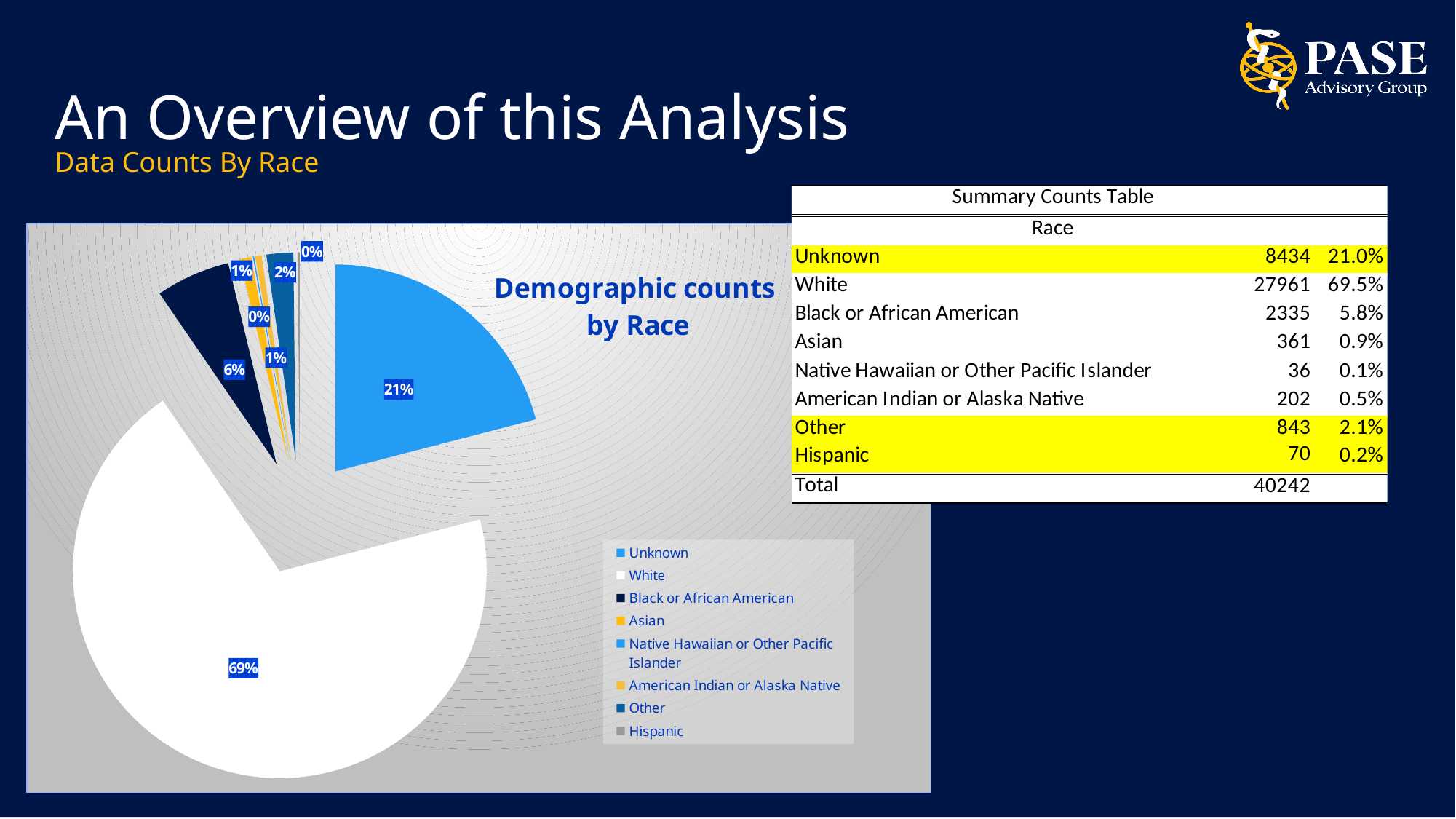
Which slice is larger, Unknown or Black or African American? Unknown What share of the pie does the Other slice represent? 2% What share of the pie does the White slice represent? 69% Which slice is larger, Other or Black or African American? Black or African American How many categories does the pie chart's legend list? 8 What share of the pie does the Black or African American slice represent? 6% What is the title of the pie chart? Demographic counts by Race Which category has the largest slice in the pie chart? White What colour is the White slice in the pie chart? white What kind of chart is shown on the slide? pie chart By how many percentage points does the White slice exceed the Unknown slice? 48 percentage points